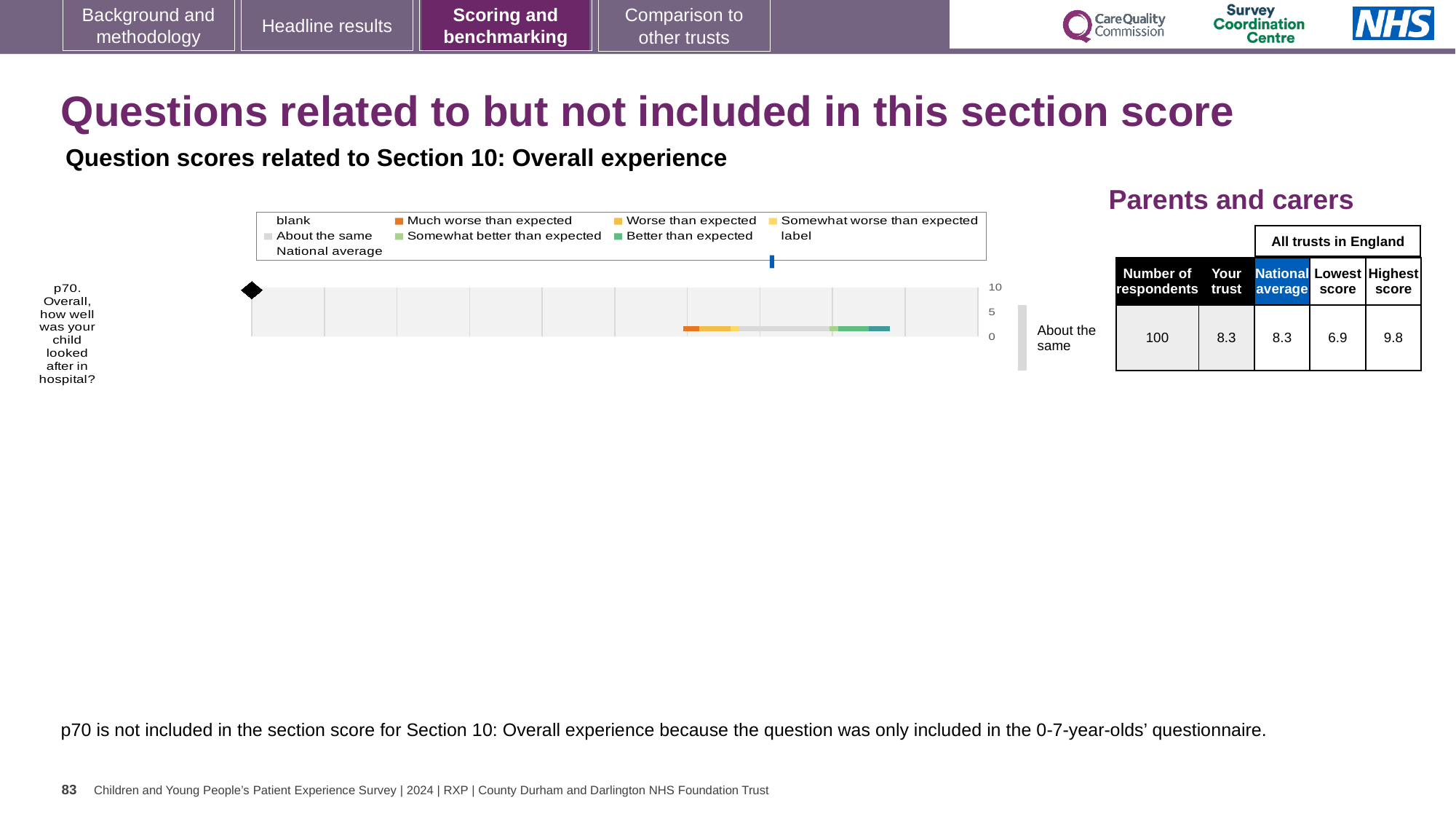
What is the difference between the highest score and the lowest score for p70? 2.9 What kind of chart is used to show the p70 question score? bar chart What is the lowest score among all trusts in England for p70? 6.9 Is the 'Your trust' score for p70 higher than, lower than, or equal to the national average? equal What is the highest score among all trusts in England for p70? 9.8 Which question is plotted in the chart? p70. Overall, how well was your child looked after in hospital? What rating category is shown to the right of the bar for p70? About the same What is the 'Your trust' score for p70 in the table? 8.3 How many questions are plotted in the chart? 1 What is the maximum value shown on the chart's score axis? 10 What is the national average score for p70 in the table? 8.3 How many respondents answered p70? 100